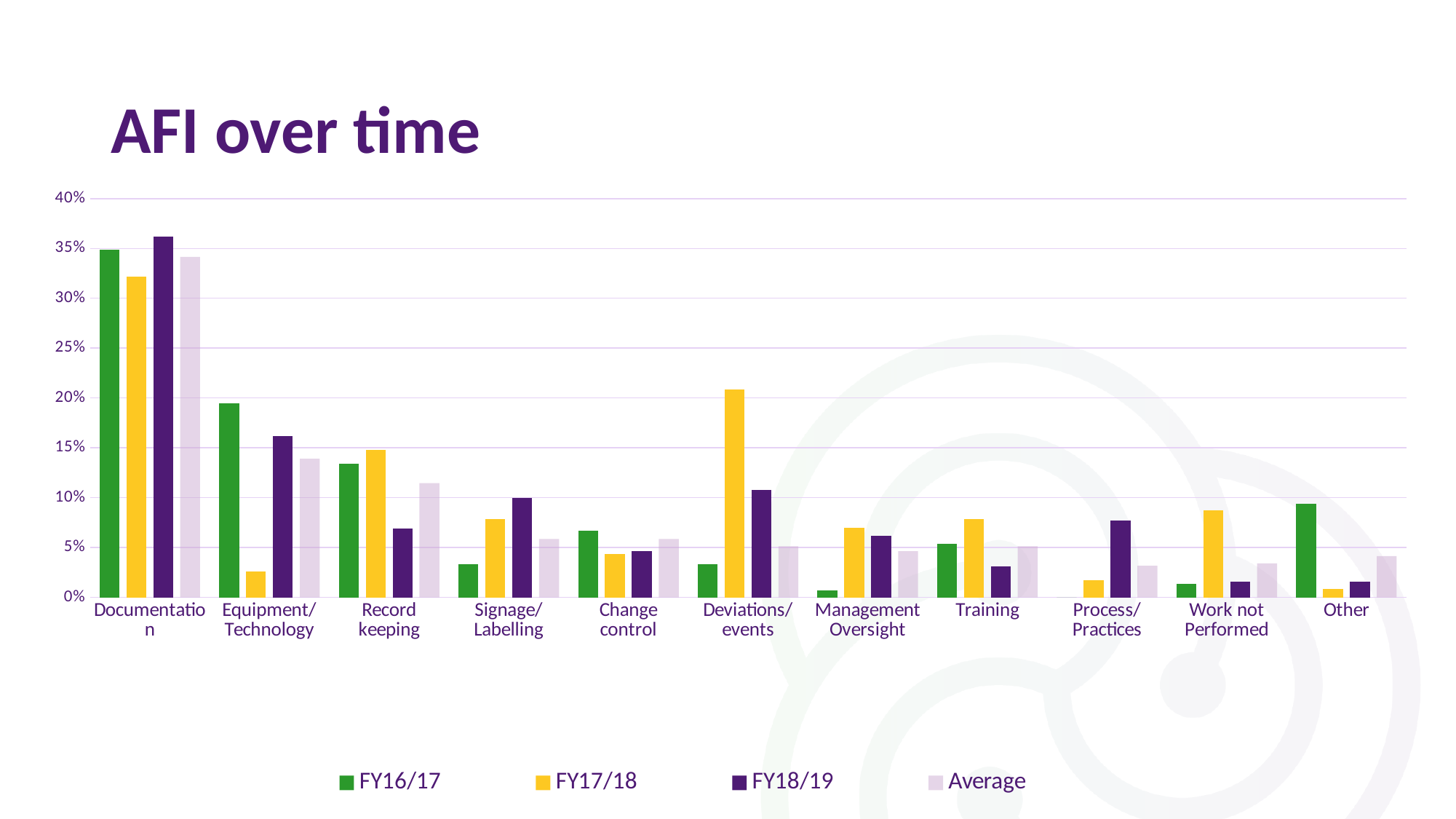
Which category has the highest FY18/19 value? Documentation Which category has the lowest FY16/17 value? Process/Practices What kind of chart is shown on the slide? bar chart How many series does the legend list? 4 Is the FY17/18 value for Deviations/events greater or less than 20%? greater Which is larger for Deviations/events: the FY17/18 value or the FY18/19 value? FY17/18 Is the FY18/19 value for Documentation greater or less than 35%? greater What is the title of the chart? AFI over time Which is larger for Other: the FY16/17 value or the FY17/18 value? FY16/17 How many categories are shown on the x axis? 11 Is the FY16/17 value for Equipment/Technology greater or less than 15%? greater Which category has the highest FY17/18 value? Documentation